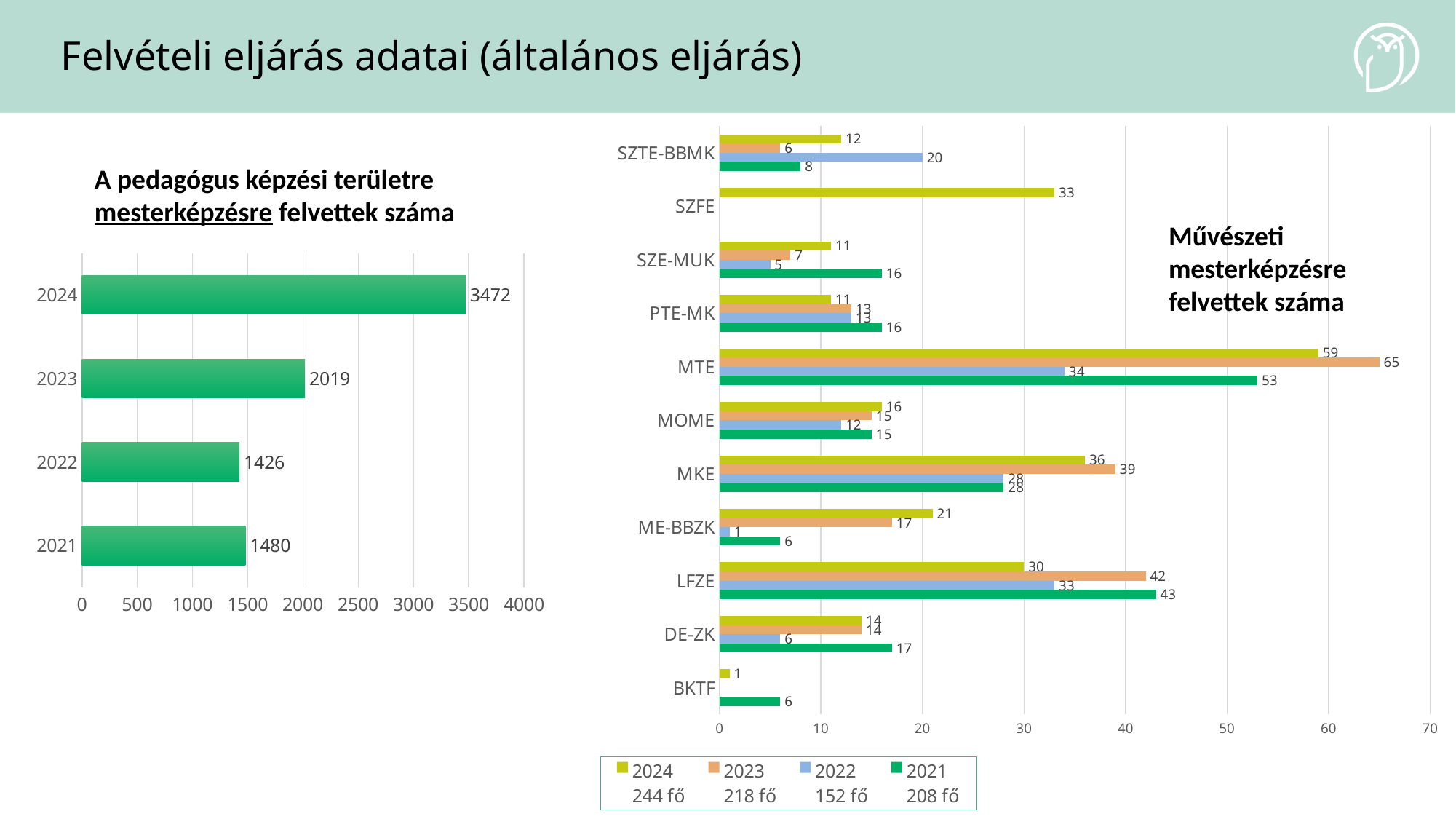
In the right chart (Művészeti mesterképzésre felvettek száma), what is the 2023 value for MTE? 65 In the left chart (A pedagógus képzési területre mesterképzésre felvettek száma), how many years are shown? 4 What type of chart is the right chart (Művészeti mesterképzésre felvettek száma)? bar chart In the right chart (Művészeti mesterképzésre felvettek száma), what is the difference between the 2022 and 2021 values for SZTE-BBMK? 12 In the left chart (A pedagógus képzési területre mesterképzésre felvettek száma), what is the value for 2024? 3472 In the right chart (Művészeti mesterképzésre felvettek száma), how many series does the legend list? 4 In the right chart (Művészeti mesterképzésre felvettek száma), which is larger for MKE: the 2024 value or the 2023 value? 2023 In the right chart (Művészeti mesterképzésre felvettek száma), which institution has the highest 2024 value? MTE In the left chart (A pedagógus képzési területre mesterképzésre felvettek száma), what is the difference between the 2024 and 2023 values? 1453 In the left chart (A pedagógus képzési területre mesterképzésre felvettek száma), which year has the lowest value? 2022 In the right chart (Művészeti mesterképzésre felvettek száma), what is the 2021 value for LFZE? 43 In the left chart (A pedagógus képzési területre mesterképzésre felvettek száma), is the value for 2021 greater or less than 1500? less